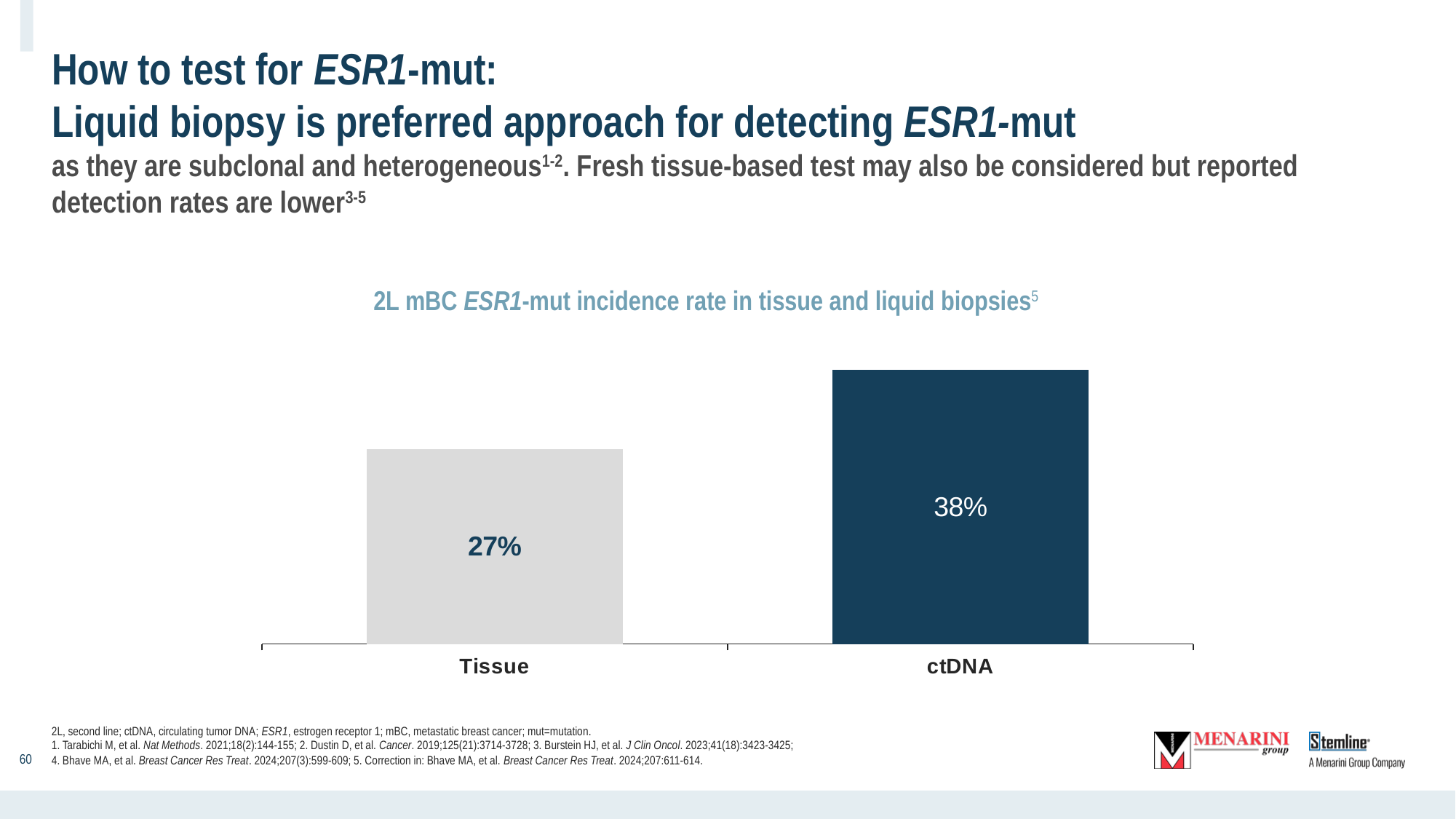
What kind of chart is shown on the slide? bar chart What is the ESR1-mut incidence rate for Tissue? 27% Which category has the higher incidence rate, Tissue or ctDNA? ctDNA What is the difference in incidence rate between ctDNA and Tissue? 11% How many categories are shown in the chart? 2 Is the value for Tissue larger or smaller than the value for ctDNA? smaller Which category has the lowest incidence rate? Tissue What is the ESR1-mut incidence rate for ctDNA? 38% What colour is the ctDNA bar? dark blue What is the title of the chart? 2L mBC ESR1-mut incidence rate in tissue and liquid biopsies